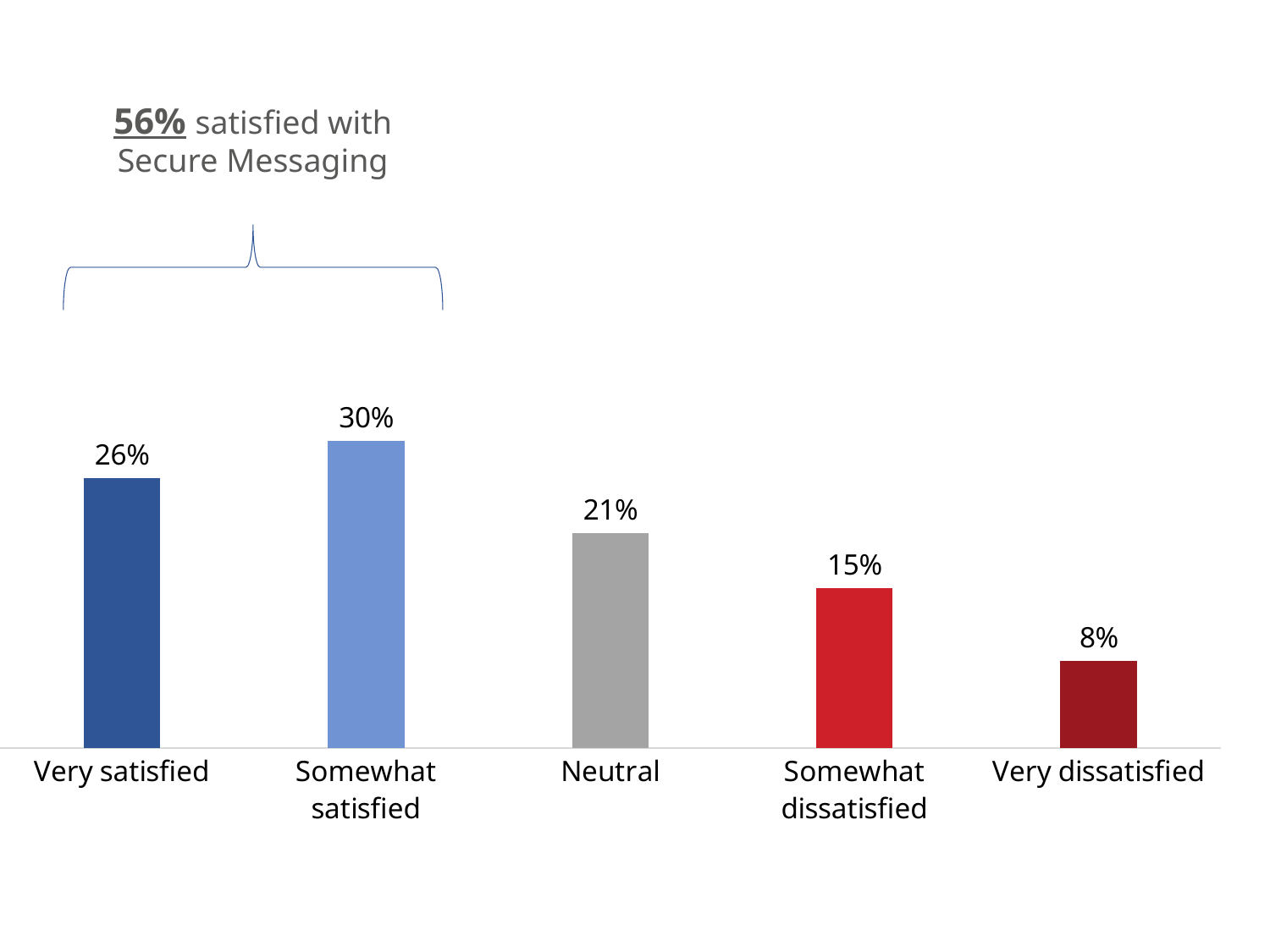
What percentage of respondents were very satisfied with Secure Messaging? 26% According to the annotation above the bracket, what percentage were satisfied with Secure Messaging? 56% What is the difference between the Somewhat satisfied and Very satisfied values? 4% Which category has the highest value? Somewhat satisfied What kind of chart is shown on the slide? Bar chart Which is larger, the value for Somewhat dissatisfied or the value for Very dissatisfied? Somewhat dissatisfied Which category has the lowest value? Very dissatisfied Do the values rise or fall from Somewhat satisfied to Very dissatisfied along the x axis? Fall What is the value shown for the Neutral category? 21% What is the difference between the Neutral and Somewhat dissatisfied values? 6% What percentage of respondents were very dissatisfied? 8% How many categories are shown on the x axis? 5